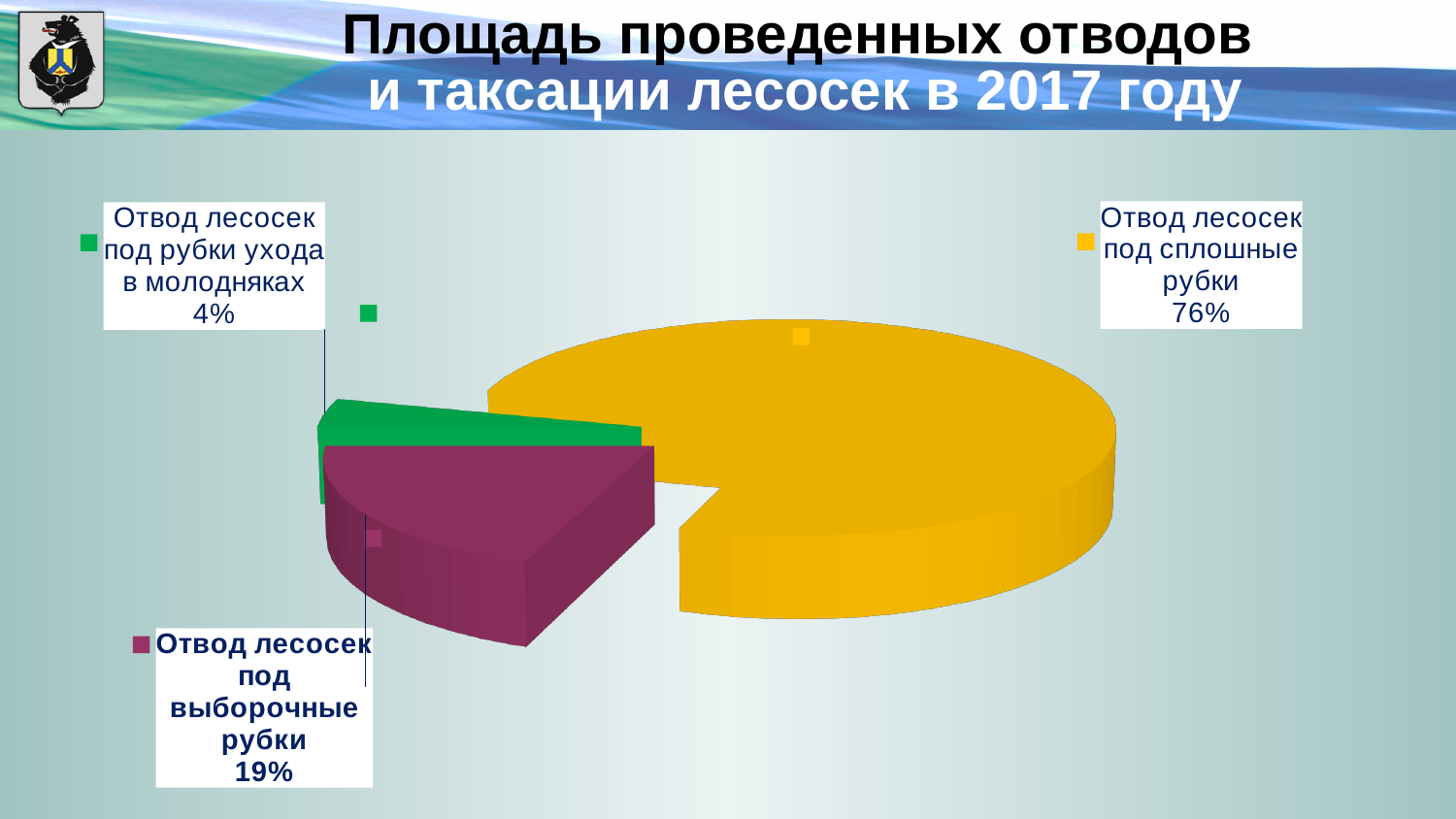
What share of the pie does "Отвод лесосек под сплошные рубки" have? 76% How many slices does the pie chart have? 3 Which category has the smallest slice of the pie? Отвод лесосек под рубки ухода в молодняках What colour is the slice for "Отвод лесосек под сплошные рубки"? Yellow Which is larger: the share for "Отвод лесосек под выборочные рубки" or for "Отвод лесосек под рубки ухода в молодняках"? Отвод лесосек под выборочные рубки What is the difference in percentage points between "Отвод лесосек под сплошные рубки" and "Отвод лесосек под выборочные рубки"? 57 What share of the pie does "Отвод лесосек под выборочные рубки" have? 19% What kind of chart is shown on the slide? Pie chart What is the title of the slide containing the chart? Площадь проведенных отводов и таксации лесосек в 2017 году What share of the pie does "Отвод лесосек под рубки ухода в молодняках" have? 4% Which category has the largest slice of the pie? Отвод лесосек под сплошные рубки What is the difference in percentage points between "Отвод лесосек под выборочные рубки" and "Отвод лесосек под рубки ухода в молодняках"? 15